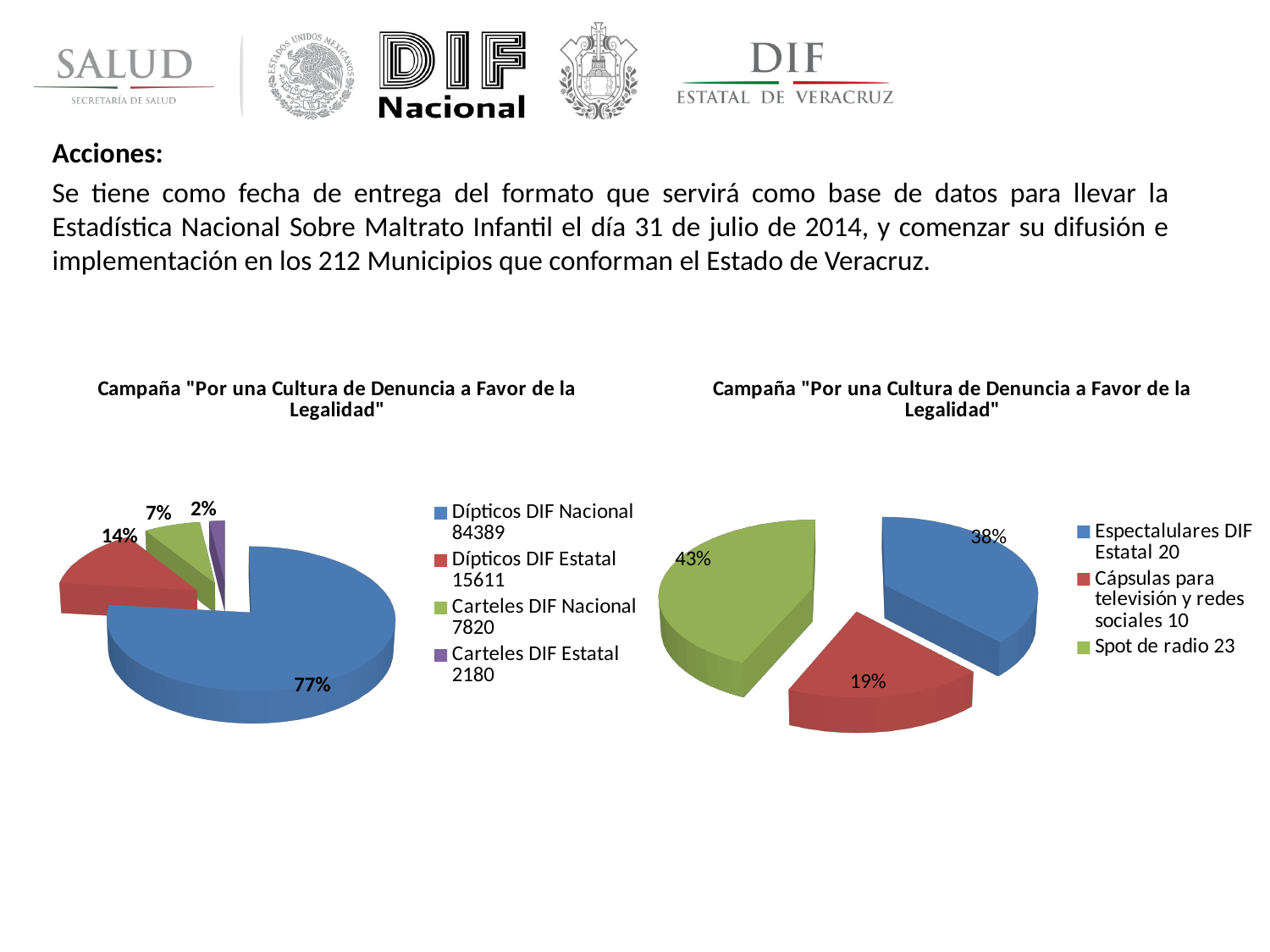
In the right pie chart, what is the difference in percentage points between the Spot de radio slice and the Espectaculares DIF Estatal slice? 5 In the right pie chart, which category has the largest slice? Spot de radio In the right pie chart, what share of the pie does Spot de radio represent? 43% In the right pie chart, how many categories does the legend list? 3 In the left pie chart, what share of the pie does Dípticos DIF Estatal represent? 14% In the left pie chart, what share of the pie does Carteles DIF Estatal represent? 2% In the left pie chart, how many categories are shown? 4 In the left pie chart, which category has the largest slice? Dípticos DIF Nacional What type of chart is the chart on the right side of the slide? Pie chart In the left pie chart, which category has the smallest slice? Carteles DIF Estatal